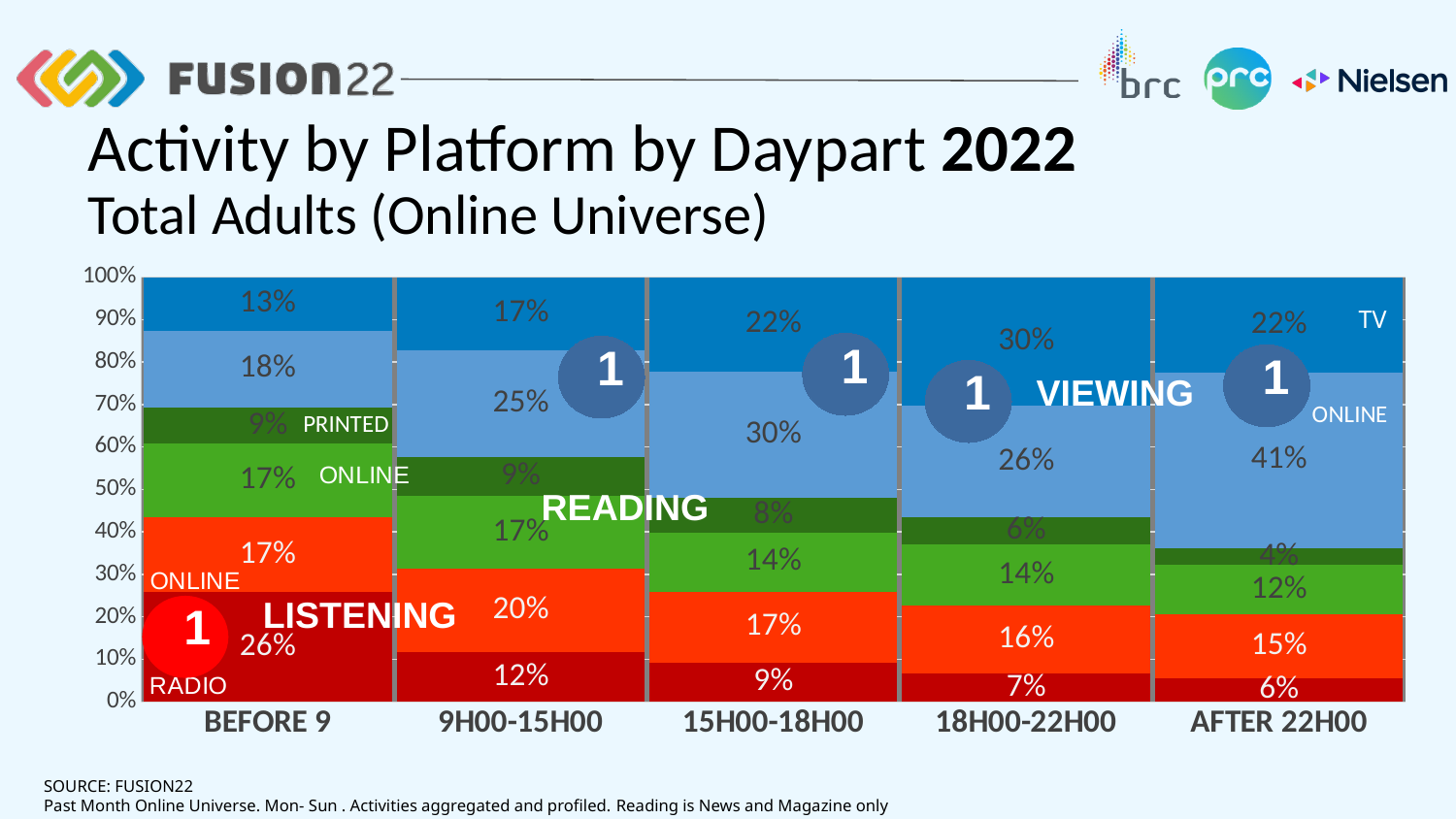
Which is larger: the online viewing share in 9H00-15H00 or in 15H00-18H00? 15H00-18H00 What is the difference between the TV share in 18H00-22H00 and the TV share in BEFORE 9? 17% What is the TV share for the 18H00-22H00 daypart? 30% What type of chart is shown on the slide? Stacked bar chart In which daypart is the printed reading share lowest? AFTER 22H00 What is the radio share for the BEFORE 9 daypart? 26% What is the title of the chart on the slide? Activity by Platform by Daypart 2022 Total Adults (Online Universe) How many dayparts are shown along the x axis? 5 In which daypart is the radio share highest? BEFORE 9 What is the printed reading share for the 15H00-18H00 daypart? 8% What is the online viewing share for the AFTER 22H00 daypart? 41% How does the radio share change across the dayparts from BEFORE 9 to AFTER 22H00? It falls